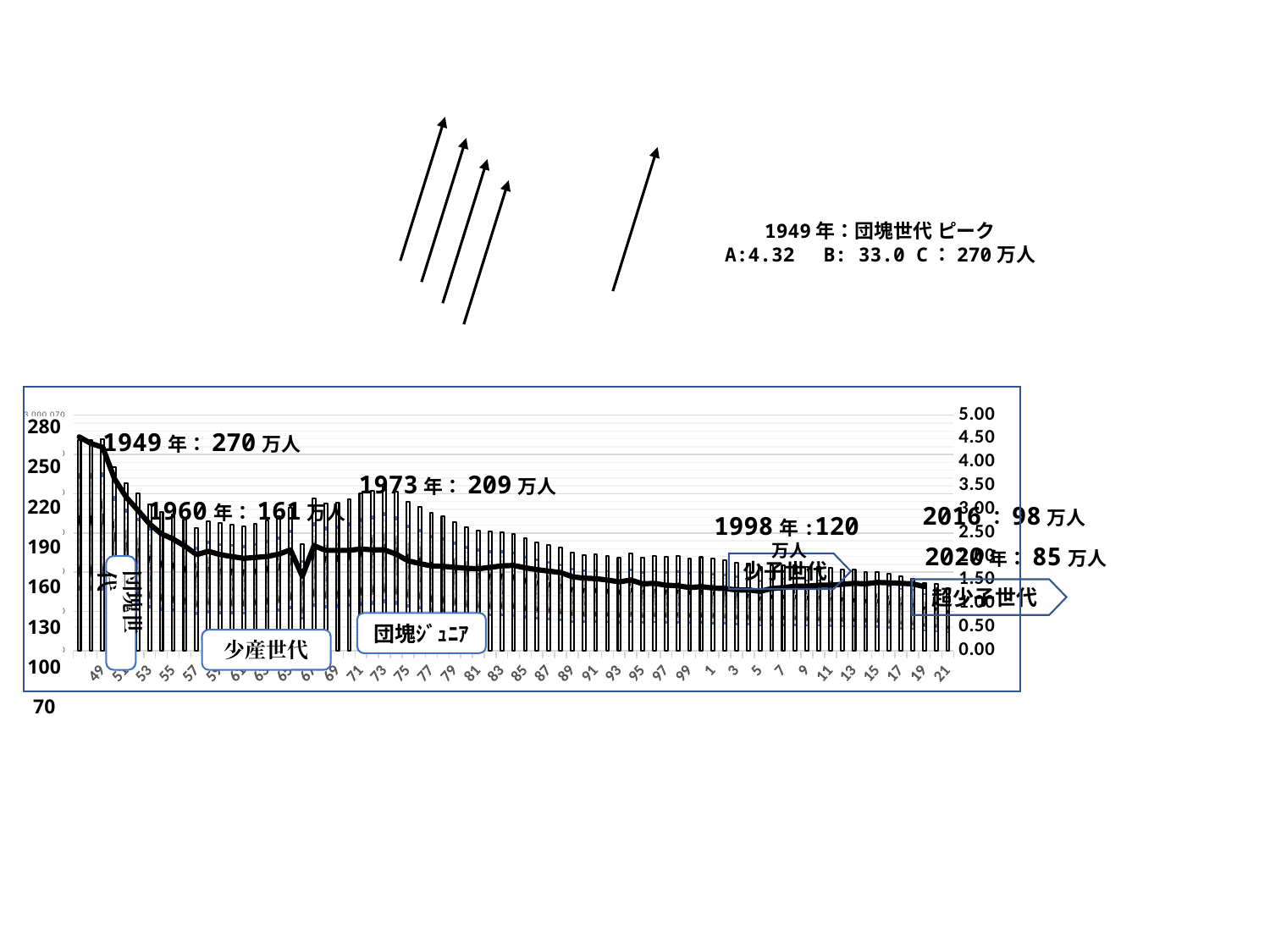
Which annotated year has the lowest value on the chart? 2020年 What value is annotated for 2016 on the chart? 98万人 What generation label is shown in the box near the 1971–1974 bars? 団塊ジュニア What value is annotated for 1973 on the chart? 209万人 What value is annotated for 1960 on the chart? 161万人 Which is larger, the annotated value for 1960 or for 1973? 1973年 What is the difference between the annotated values for 1949 and 2020? 185万人 Which annotated year has the highest value on the chart? 1949年 What value is annotated for 2020 on the chart? 85万人 What value is annotated for 1949 on the chart? 270万人 What is the difference between the annotated values for 1949 and 1973? 61万人 Do the values generally rise or fall from left to right along the x axis? fall